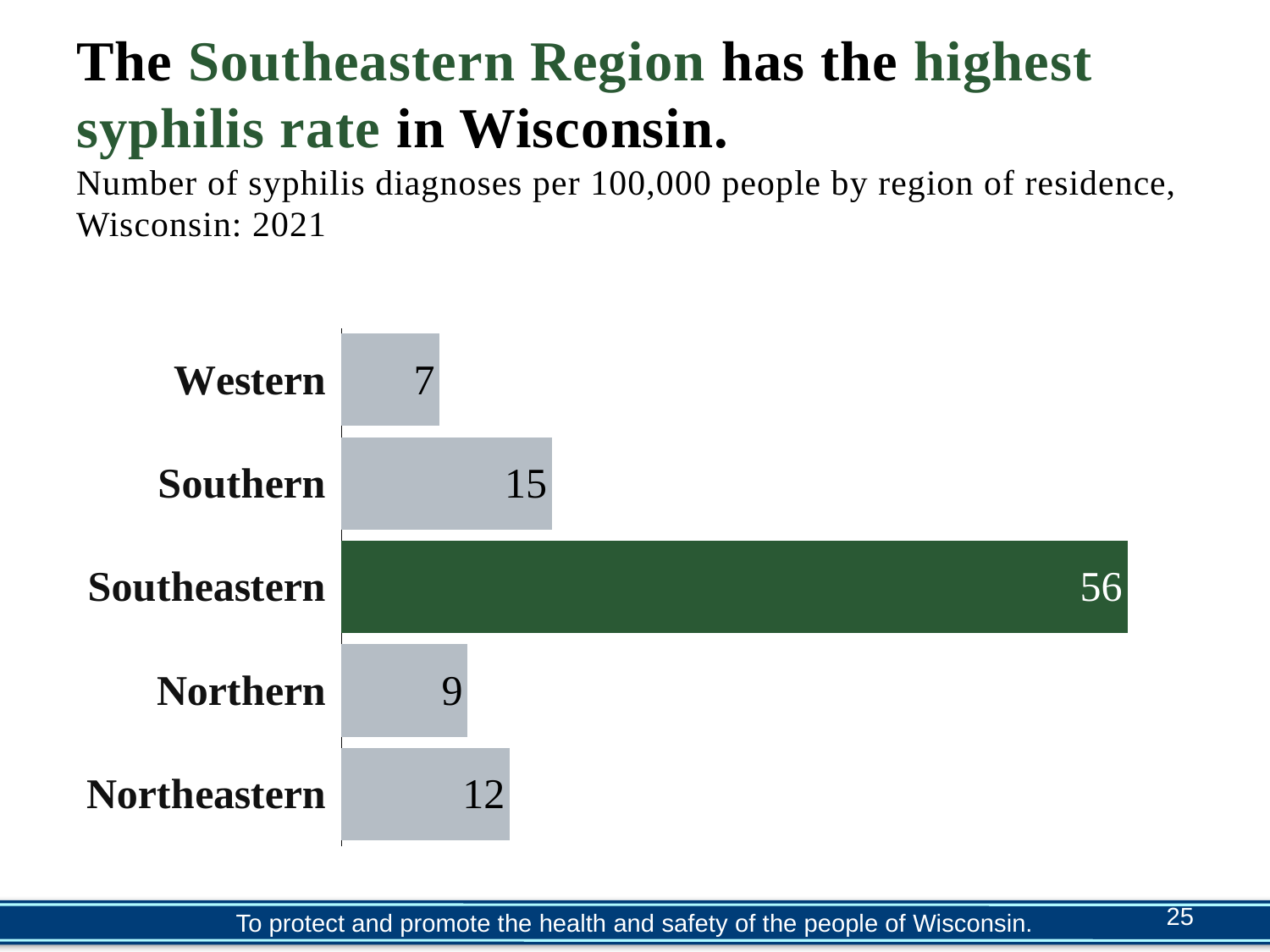
What type of chart is shown on the slide? Bar chart How many regions are shown in the chart? 5 What is the syphilis rate per 100,000 people for the Western region? 7 Which region has a higher syphilis rate, Northeastern or Western? Northeastern What is the difference between the syphilis rates of the Northeastern and Northern regions? 3 Which region's bar is highlighted in dark green? Southeastern What is the syphilis rate per 100,000 people for the Northeastern region? 12 What is the syphilis rate per 100,000 people for the Southeastern region? 56 Which region has the highest syphilis rate? Southeastern Which region has the lowest syphilis rate? Western What is the difference between the syphilis rates of the Southeastern and Southern regions? 41 Which region has a higher syphilis rate, Southern or Northern? Southern